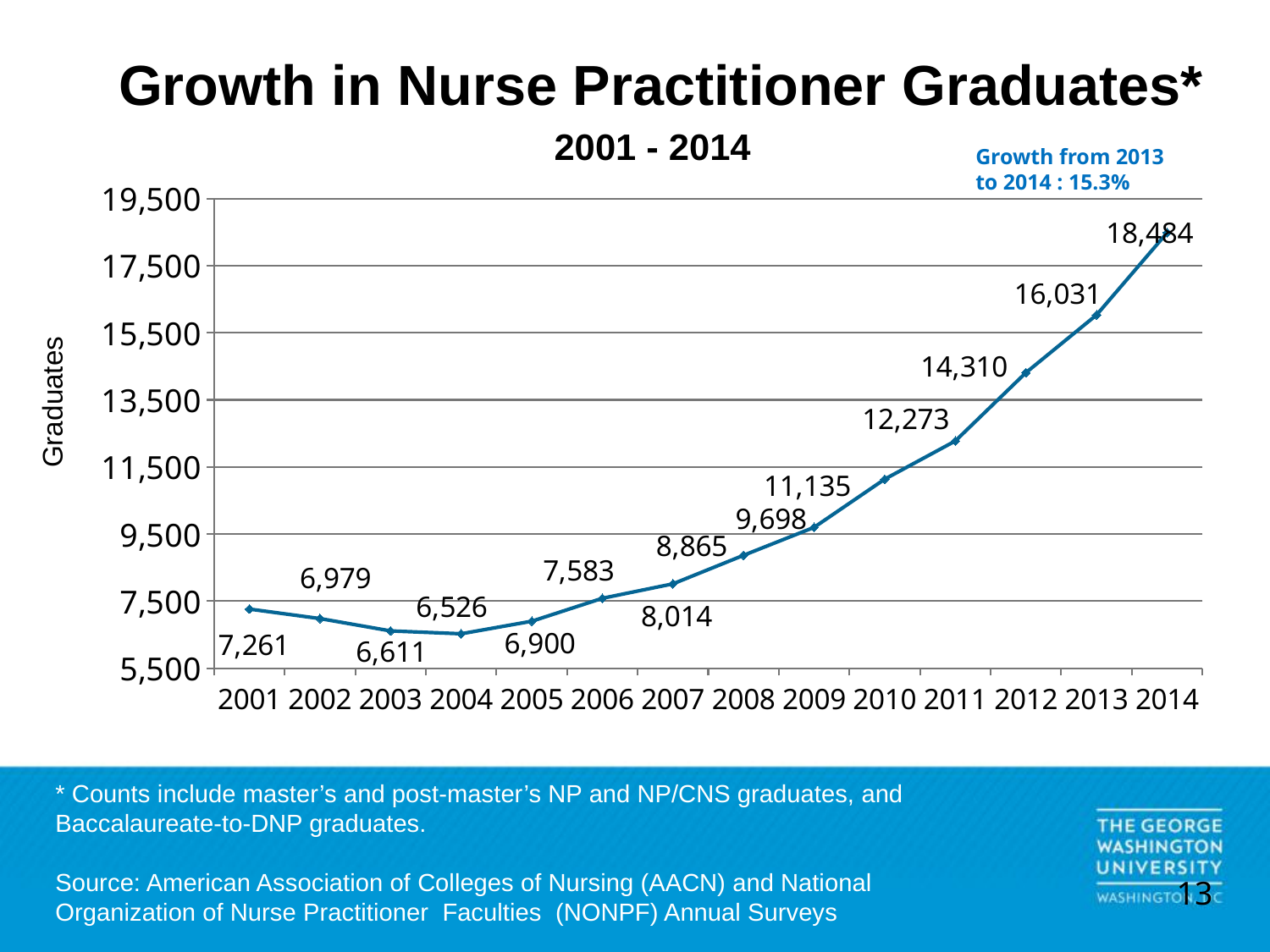
Which year has the lowest number of graduates? 2004 What is the number of graduates shown for 2014? 18,484 Do the values rise or fall from 2005 to 2014? rise What is the difference in graduates between 2014 and 2013? 2,453 What is the value plotted for 2008? 8,865 How many years are plotted on the x axis? 14 Which year has the highest number of graduates? 2014 How many nurse practitioner graduates were there in 2001? 7,261 What type of chart is shown on the slide? line chart What growth percentage from 2013 to 2014 is noted on the chart? 15.3% Which year had more graduates, 2001 or 2005? 2001 What is the label on the y axis? Graduates